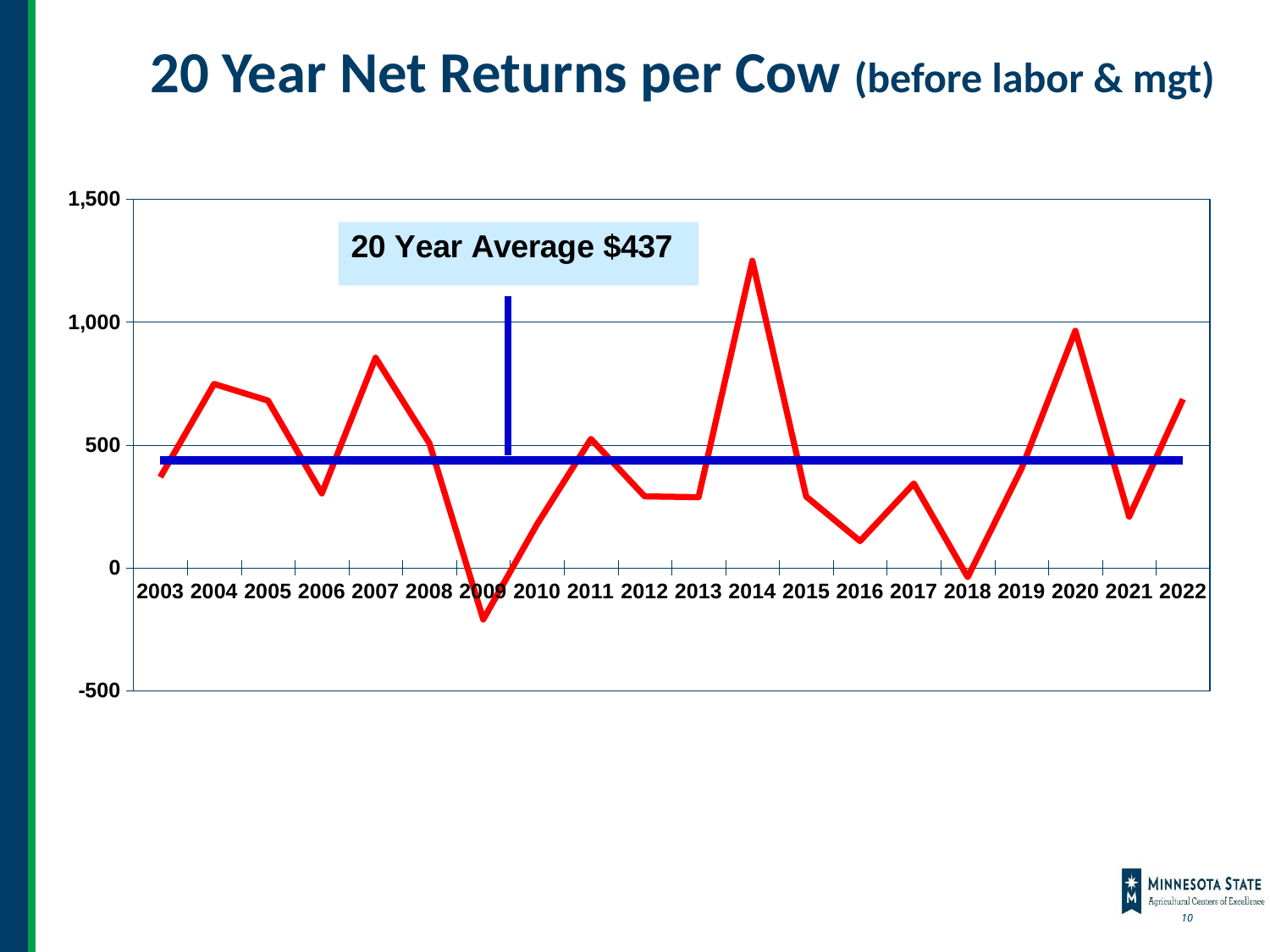
How many years are plotted along the x axis? 20 Is the value for 2007 greater or less than 500? greater Which year has the lowest net return per cow? 2009 Which year has the larger net return per cow, 2014 or 2020? 2014 Is the value for 2009 greater or less than 0? less What kind of chart is shown on the slide? line chart What is the first year shown on the x axis? 2003 Is the value for 2016 greater or less than 500? less Do net returns per cow rise or fall from 2013 to 2014? rise What 20 year average value is labeled on the chart? $437 Which year has the highest net return per cow? 2014